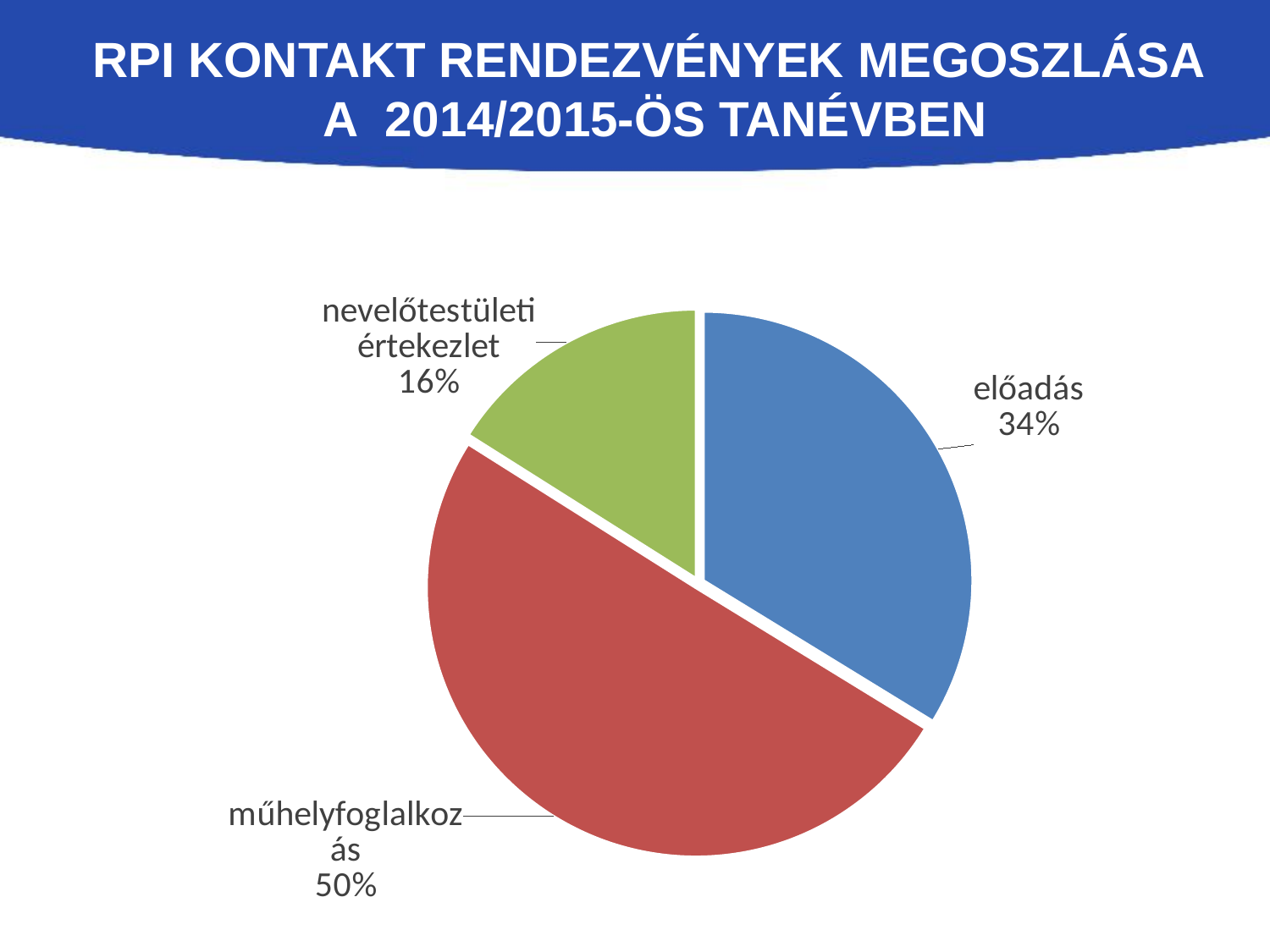
What share of the pie does the "műhelyfoglalkozás" slice represent? 50% What share of the pie does the "előadás" slice represent? 34% What kind of chart is shown on the slide? pie chart What is the difference in percentage points between the "műhelyfoglalkozás" and "előadás" shares? 16 How many slices does the pie chart have? 3 Which is larger, the share for "előadás" or the share for "nevelőtestületi értekezlet"? előadás What is the difference in percentage points between the "előadás" and "nevelőtestületi értekezlet" shares? 18 What colour is the "műhelyfoglalkozás" slice? red Which category has the largest share of the pie? műhelyfoglalkozás What is the title of the slide containing the chart? RPI KONTAKT RENDEZVÉNYEK MEGOSZLÁSA A 2014/2015-ÖS TANÉVBEN What share of the pie does the "nevelőtestületi értekezlet" slice represent? 16% Which category has the smallest share of the pie? nevelőtestületi értekezlet